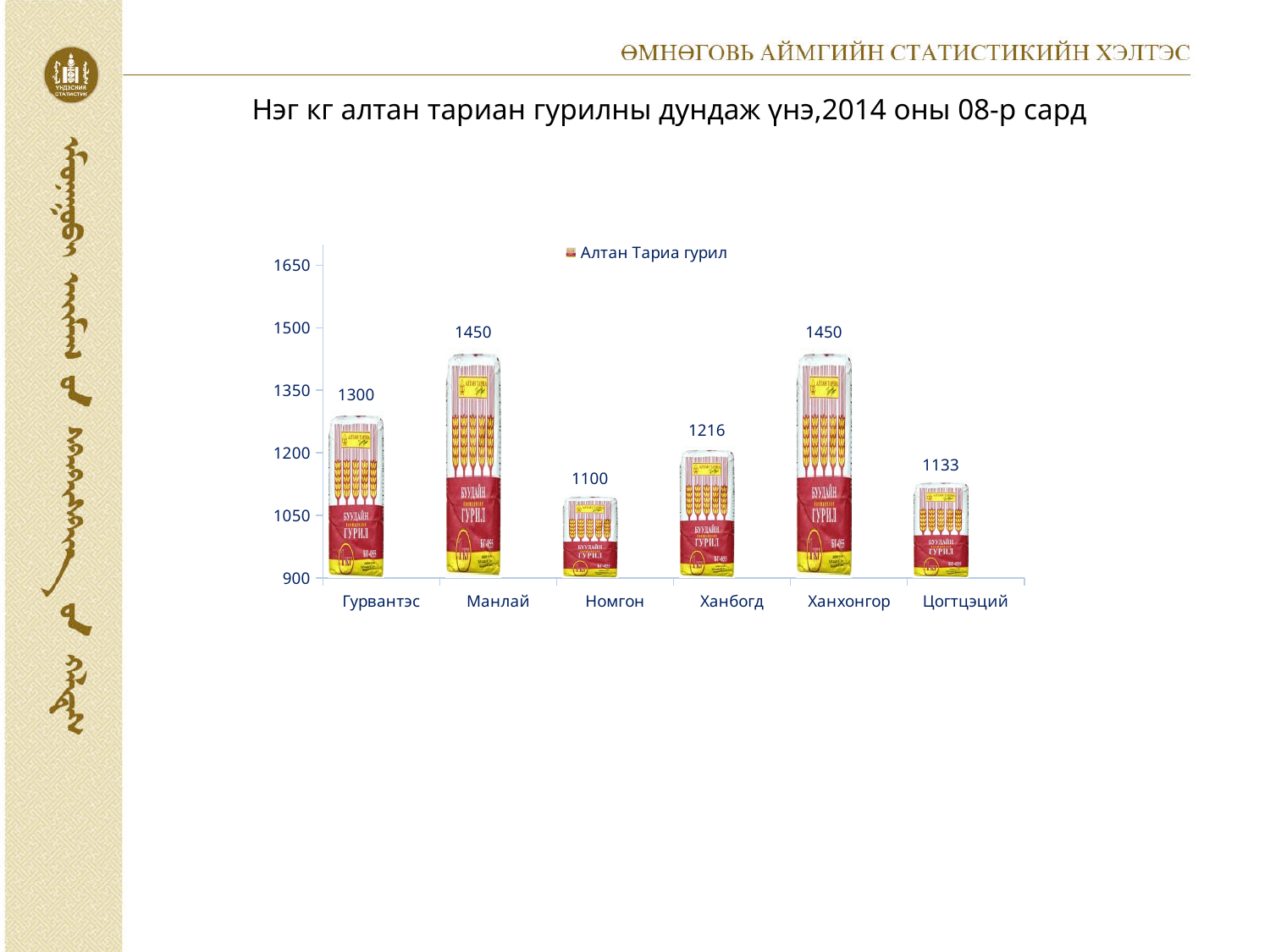
Is the value for Ханхонгор greater or less than 1350? greater What kind of chart is shown on the slide? bar chart Which is larger, the value for Гурвантэс or the value for Ханбогд? Гурвантэс What is the legend entry shown on the chart? Алтан Тариа гурил Which category has the lowest value? Номгон What is the value for Манлай? 1450 What is the value for Номгон? 1100 What is the value for Ханбогд? 1216 What is the difference between the values for Гурвантэс and Номгон? 200 How many categories are shown on the x axis? 6 What is the value for Цогтцэций? 1133 What is the difference between the values for Ханбогд and Цогтцэций? 83